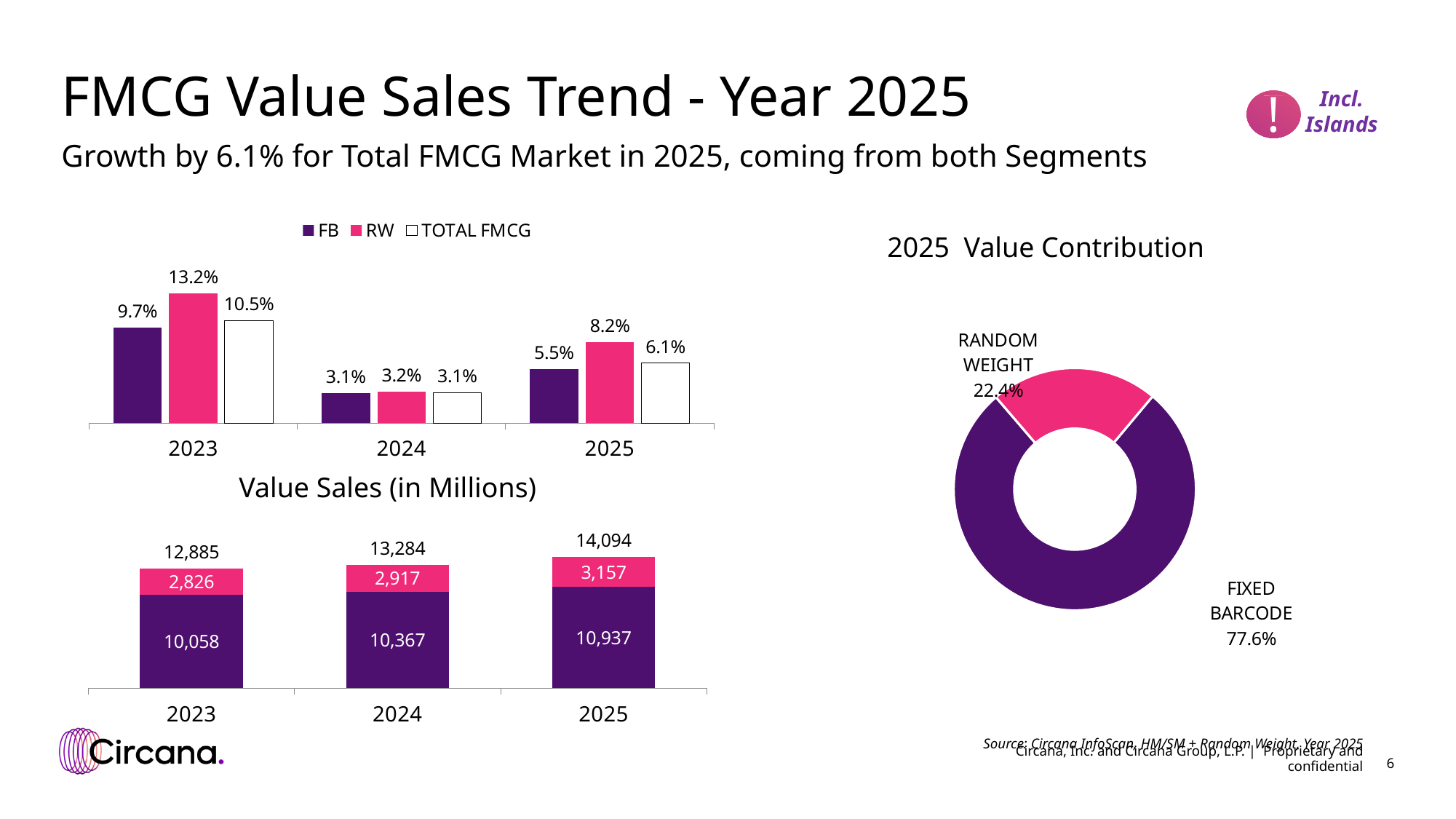
In the 'Value Sales (in Millions)' chart, what is the FB value for 2024? 10,367 In the top-left growth chart, how many series does the legend list? 3 In the 'Value Sales (in Millions)' chart, do the total values rise or fall from 2023 to 2025? rise In the top-left growth chart, which year has the highest FB value? 2023 In the top-left growth chart, which year has the lowest RW value? 2024 What kind of chart is the '2025 Value Contribution' chart? donut chart In the top-left growth chart, what is the difference between the RW and FB values for 2025? 2.7% In the 'Value Sales (in Millions)' chart, what is the difference between the RW values for 2025 and 2023? 331 In the top-left growth chart, what is the TOTAL FMCG value for 2025? 6.1% In the top-left growth chart, what is the RW value for 2023? 13.2% In the 'Value Sales (in Millions)' chart, what is the total of the stacked bar for 2025? 14,094 In the '2025 Value Contribution' chart, what share does RANDOM WEIGHT have? 22.4%